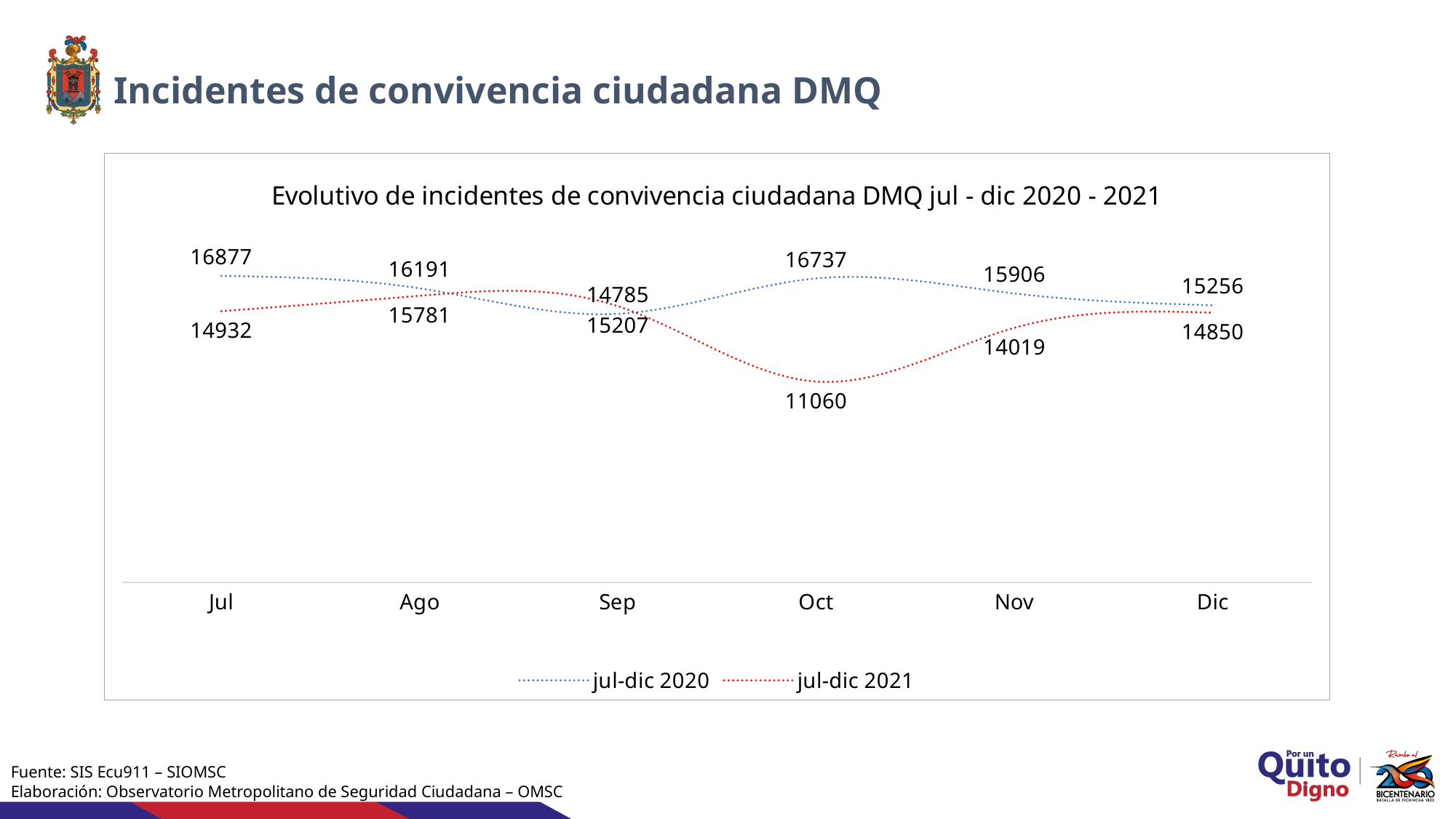
What is the difference between jul-dic 2020 and jul-dic 2021 in Oct? 5677 Which series has the larger value in Jul, jul-dic 2020 or jul-dic 2021? jul-dic 2020 What is the value for jul-dic 2020 in Dic? 15256 Does the jul-dic 2021 series rise or fall from Sep to Oct? Fall In which month is the jul-dic 2020 series highest? Jul How many months are shown on the x axis? 6 What type of chart is shown on the slide? Line chart What is the value for jul-dic 2021 in Oct? 11060 What is the value for jul-dic 2021 in Nov? 14019 In which month is the jul-dic 2021 series lowest? Oct What is the value for jul-dic 2020 in Jul? 16877 How many series does the legend list? 2